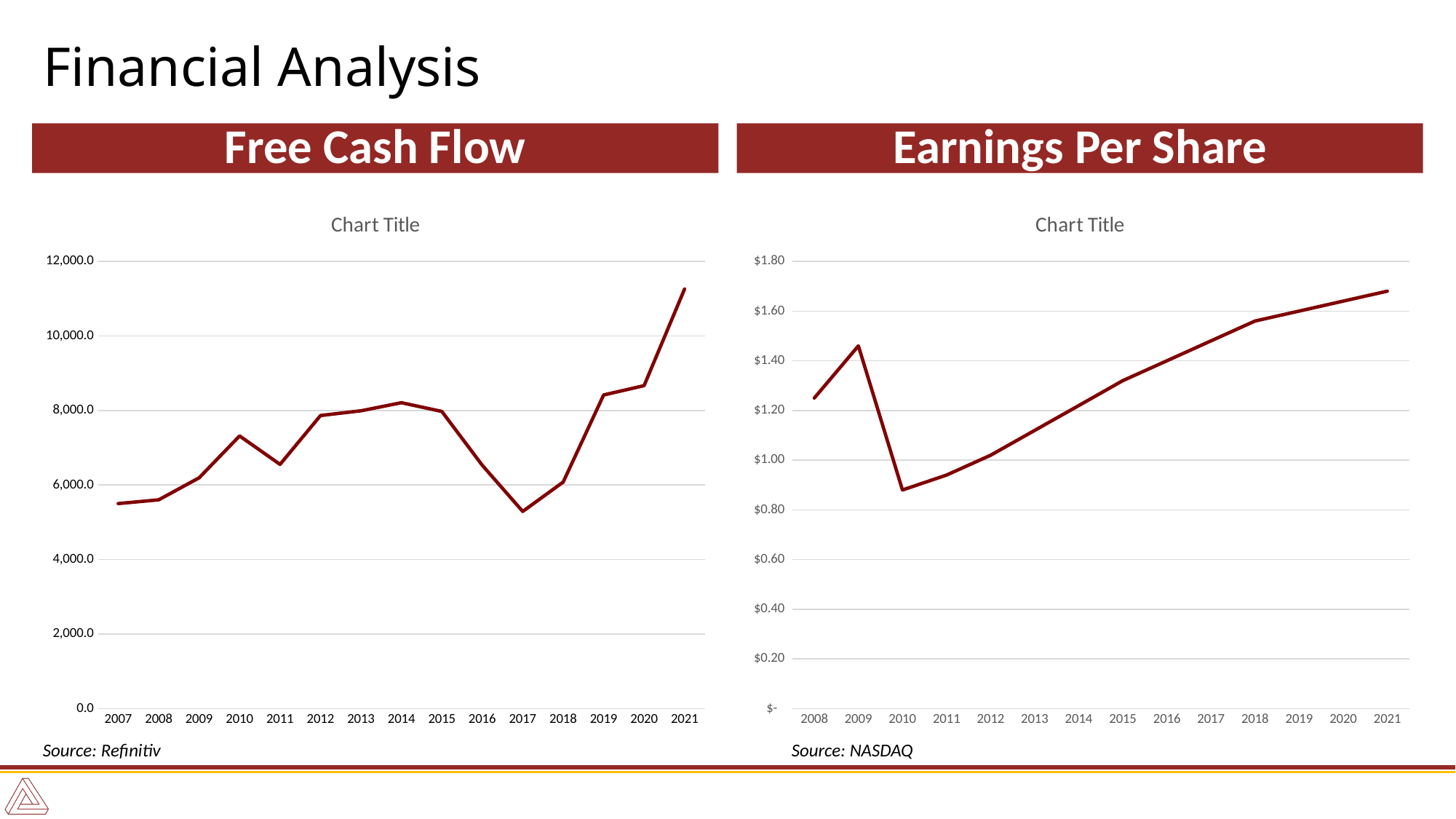
On the Free Cash Flow chart, is the value for 2021 greater or less than 10,000.0? greater On the Earnings Per Share chart, which year has the highest value? 2021 On the Free Cash Flow chart, which year has the larger value, 2010 or 2011? 2010 What kind of chart is the Free Cash Flow chart? line chart On the Earnings Per Share chart, do the values rise or fall from 2010 to 2021? rise On the Earnings Per Share chart, is the value for 2009 greater or less than $1.40? greater How many years are plotted on the Earnings Per Share chart? 14 On the Free Cash Flow chart, which year has the highest value? 2021 On the Free Cash Flow chart, which year has the lowest value? 2017 On the Free Cash Flow chart, is the value for 2017 greater or less than 6,000.0? less On the Earnings Per Share chart, which year has the lowest value? 2010 How many years are plotted on the Free Cash Flow chart? 15